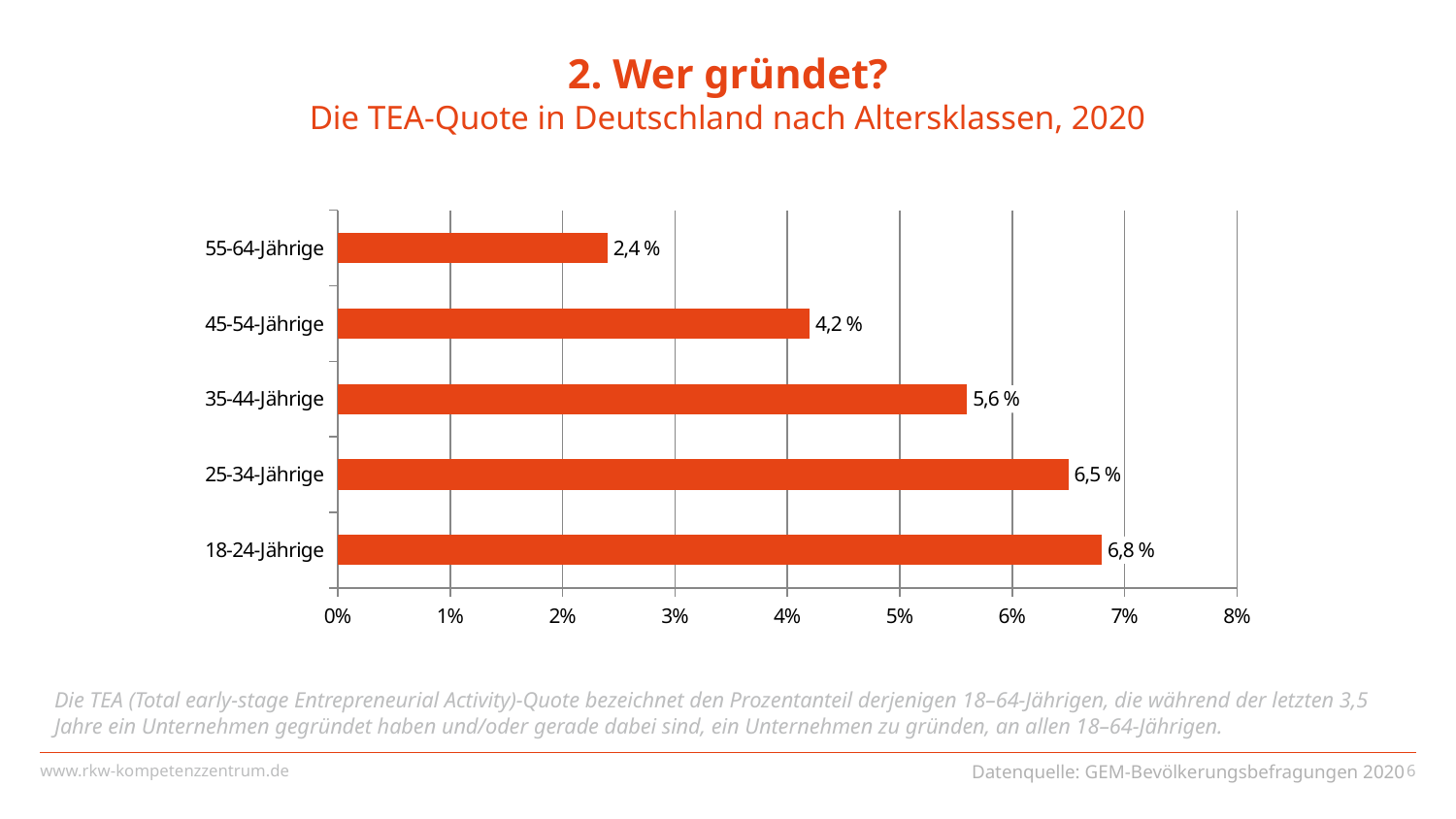
What is the TEA rate for the 18-24-Jährige age group? 6,8 % Reading the bars from top to bottom (oldest to youngest age group), do the TEA rates rise or fall? Rise How many age groups are shown in the chart? 5 Which has a higher TEA rate, the 35-44-Jährige or the 45-54-Jährige group? 35-44-Jährige What is the subtitle of the chart on the slide? Die TEA-Quote in Deutschland nach Altersklassen, 2020 Is the TEA rate for the 25-34-Jährige group greater or less than 6%? greater Which age group has the highest TEA rate? 18-24-Jährige Which age group has the lowest TEA rate? 55-64-Jährige What kind of chart is shown on the slide? Bar chart What is the difference between the TEA rates of the 25-34-Jährige and the 45-54-Jährige groups? 2,3 % What is the TEA rate for the 35-44-Jährige age group? 5,6 % What is the TEA rate for the 55-64-Jährige age group? 2,4 %